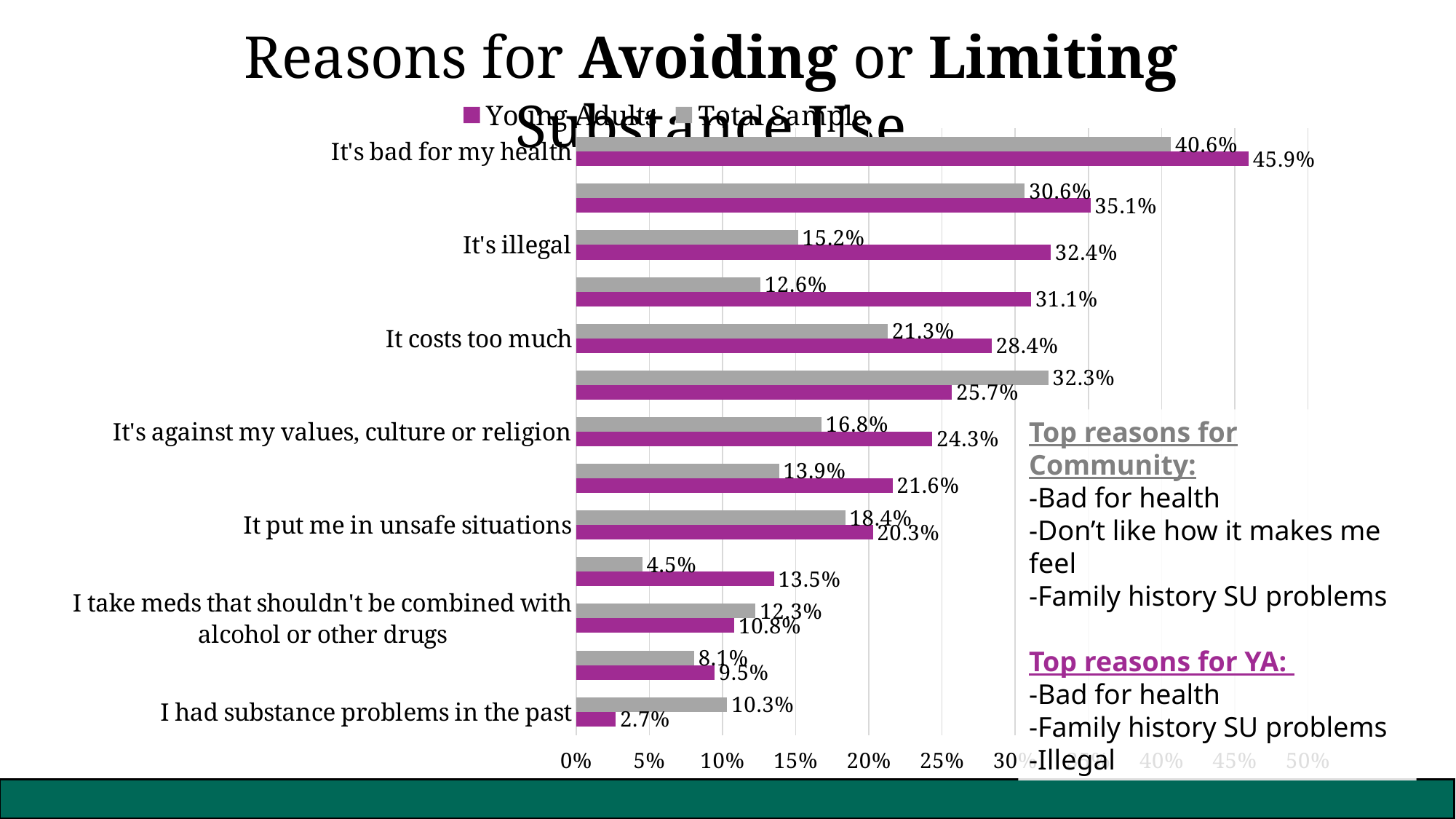
What is the Total Sample value for "It's illegal"? 15.2% How many series does the legend list? 2 Is the Total Sample value for "It costs too much" greater or less than 20%? greater Which reason has the highest Young Adults value? It's bad for my health What is the difference between the Young Adults and Total Sample values for "It's bad for my health"? 5.3 percentage points What is the Young Adults value for "It's bad for my health"? 45.9% What is the difference between the Young Adults and Total Sample values for "It's illegal"? 17.2 percentage points What is the Total Sample value for "I had substance problems in the past"? 10.3% For "I take meds that shouldn't be combined with alcohol or other drugs", which series has the larger value, Young Adults or Total Sample? Total Sample What kind of chart is shown on the slide? bar chart For "It put me in unsafe situations", which series has the larger value, Young Adults or Total Sample? Young Adults Which reason has the lowest Young Adults value? I had substance problems in the past